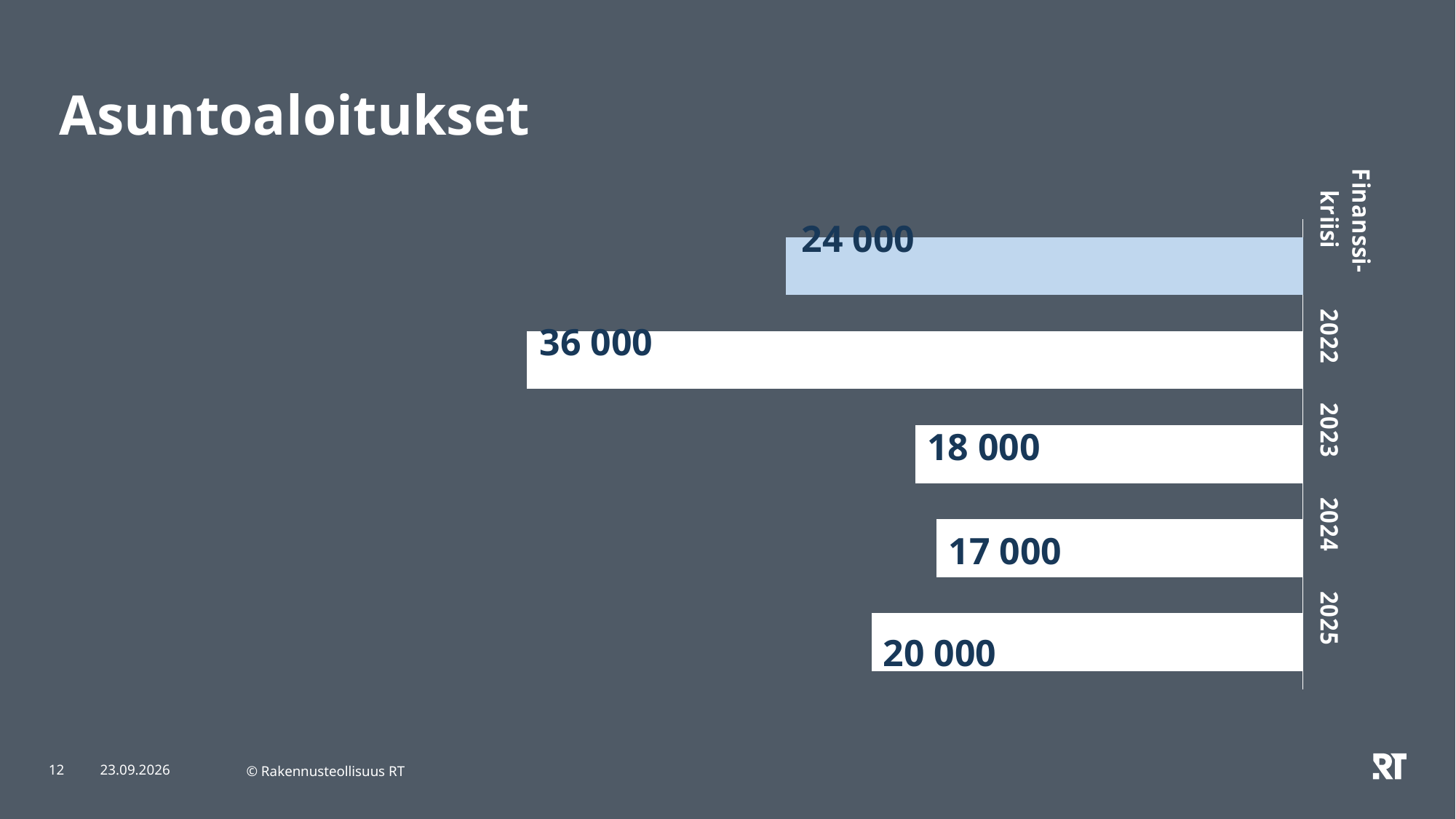
What kind of chart is shown on the slide? Bar chart How many categories are shown in the chart? 5 What is the title of the slide? Asuntoaloitukset What is the difference between the values for 2022 and 2023? 18 000 Which category has the highest value? 2022 What is the value for Finanssikriisi? 24 000 What is the value for 2025? 20 000 Which category has the lowest value? 2024 What is the difference between the values for 2025 and 2024? 3 000 What is the value for 2024? 17 000 Which is larger, the value for Finanssikriisi or the value for 2025? Finanssikriisi What is the value for 2022? 36 000